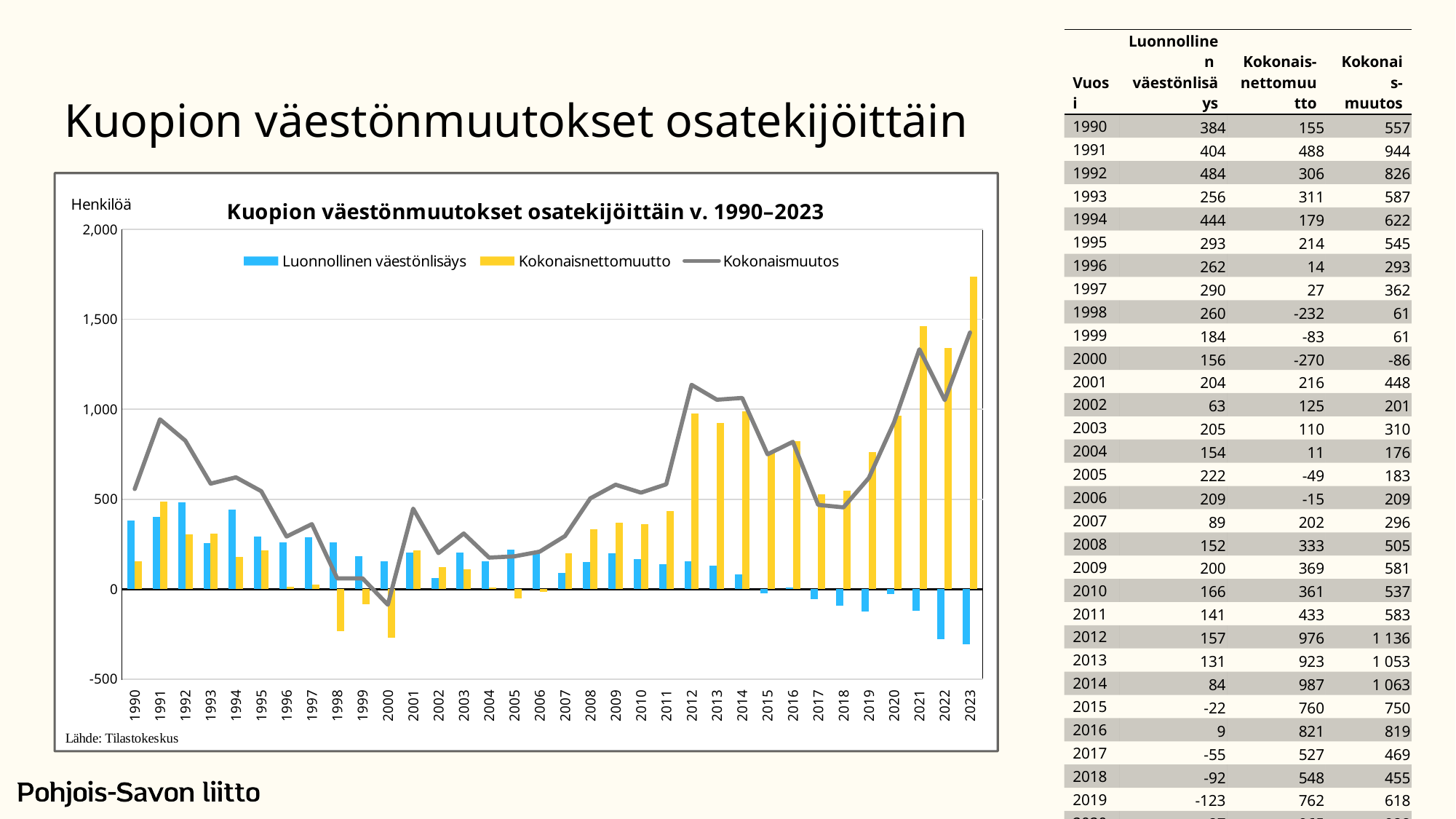
Is the Kokonaismuutos value for 2012 greater or less than 1,000? greater What is the Kokonaismuutos value for 1991 shown on the slide? 944 How many years are plotted along the x axis of the chart? 34 In which year is the Kokonaisnettomuutto bar lowest? 2000 Is the Kokonaisnettomuutto value for 2023 greater or less than 1,500? greater Does the Luonnollinen väestönlisäys series rise or fall from 2015 to 2023? fall Is the Kokonaismuutos value for 2000 greater or less than 0? less Which year has the larger Luonnollinen väestönlisäys value, 1992 or 2023? 1992 How many series does the chart legend list? 3 In which year is the Kokonaisnettomuutto bar highest? 2023 What source is cited below the chart? Tilastokeskus What kind of chart is shown on the slide? bar chart with a line